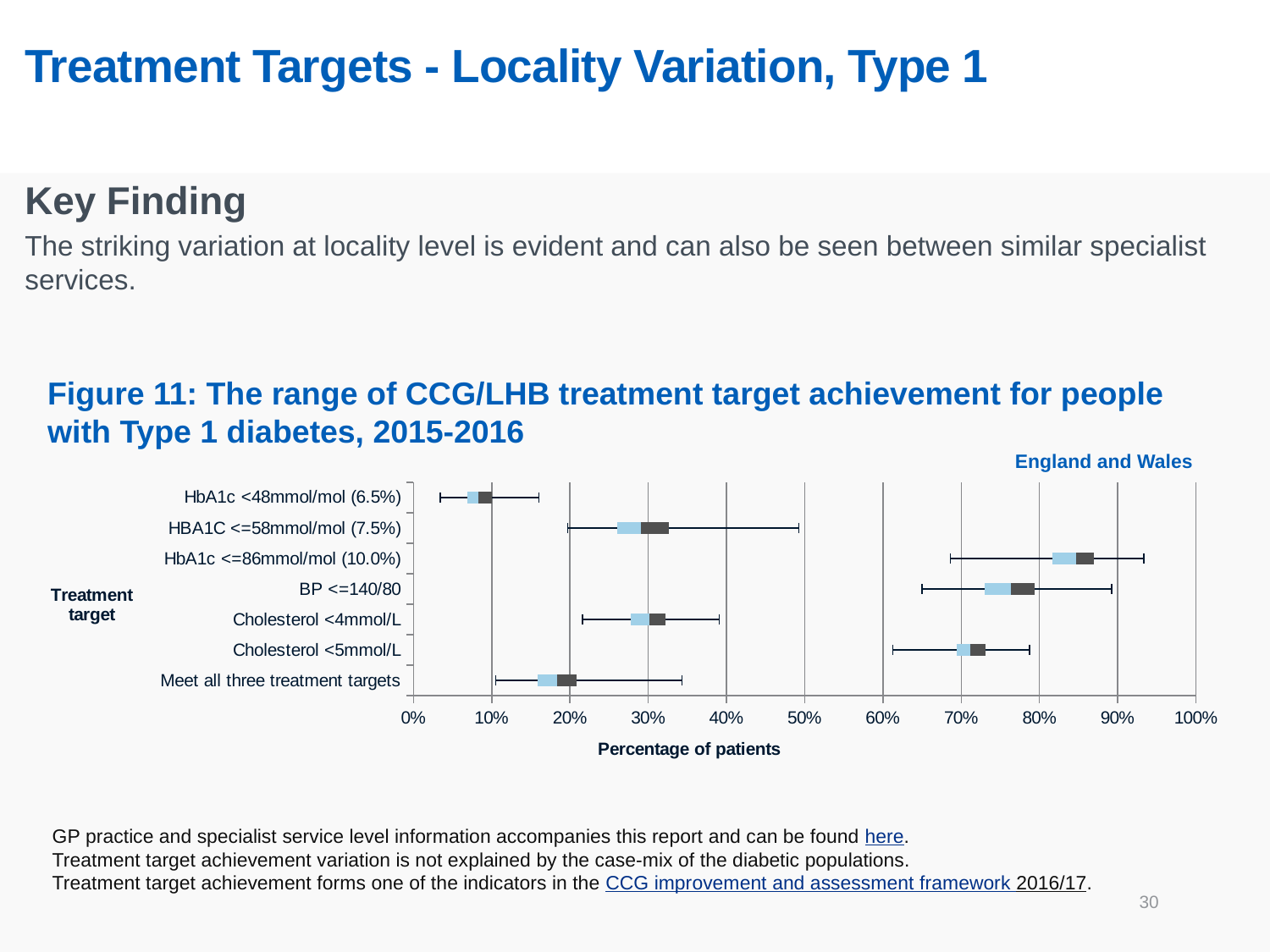
Which has the higher achievement range: Cholesterol <4mmol/L or Cholesterol <5mmol/L? Cholesterol <5mmol/L Which treatment target has the highest achievement range on the chart? HbA1c <=86mmol/mol (10.0%) Is the central value for BP <=140/80 greater or less than 70%? greater Which treatment target has the lowest achievement range on the chart? HbA1c <48mmol/mol (6.5%) Which has the higher achievement range: HbA1c <=86mmol/mol (10.0%) or BP <=140/80? HbA1c <=86mmol/mol (10.0%) Is the central value for HbA1c <=86mmol/mol (10.0%) greater or less than 80%? greater How many treatment targets are plotted on the chart? 7 Is the central value for HbA1c <48mmol/mol (6.5%) greater or less than 20%? less What kind of chart is shown in Figure 11? Box plot (range chart with whiskers) What is the label on the horizontal axis of the chart? Percentage of patients